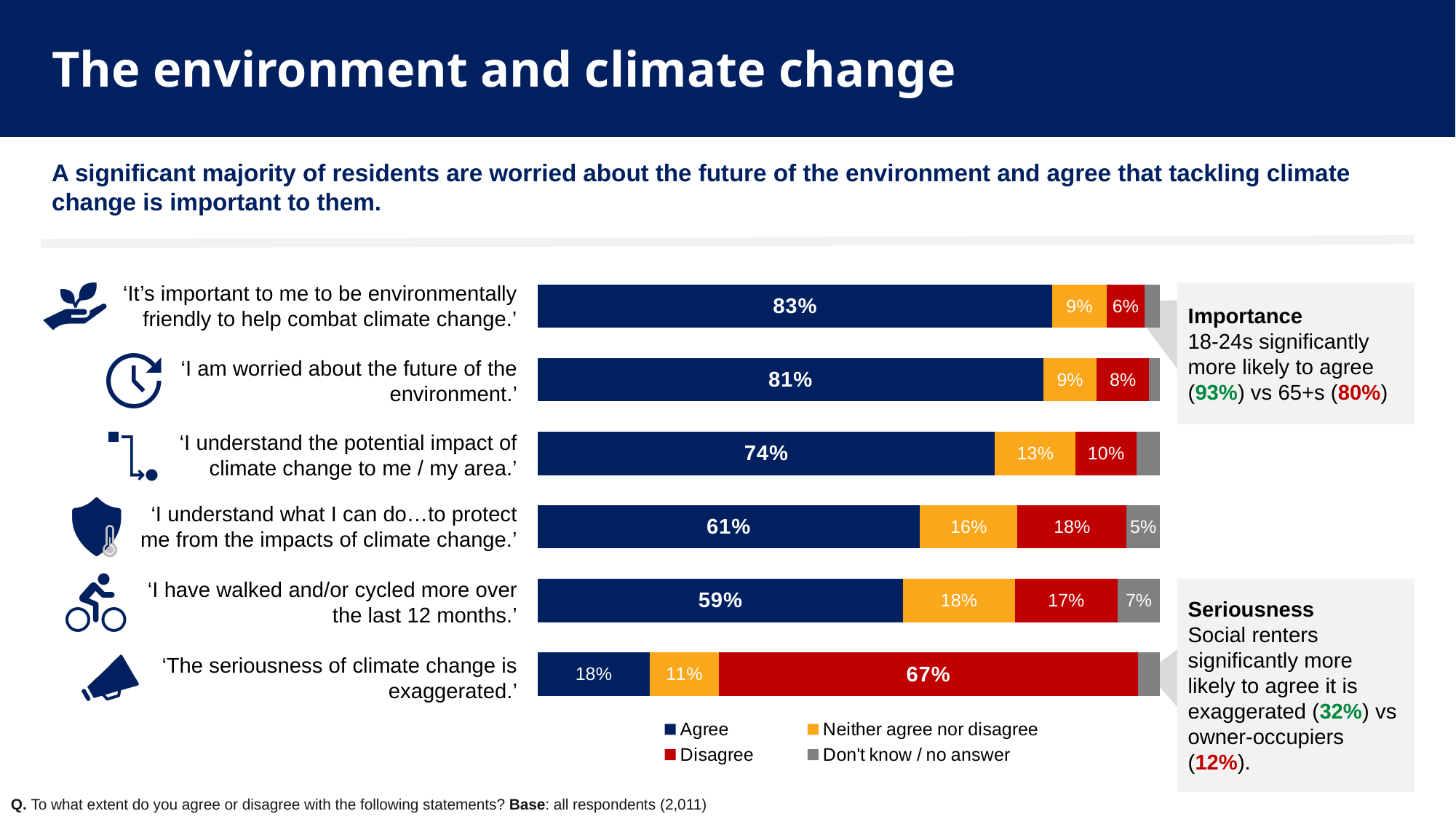
What is the 'Neither agree nor disagree' value for 'I understand the potential impact of climate change to me / my area'? 13% What type of chart is used on this slide? Stacked bar chart Which statement has the highest 'Agree' percentage? 'It's important to me to be environmentally friendly to help combat climate change.' How many response categories does the legend list? 4 Which has a higher 'Disagree' percentage: 'I understand what I can do…to protect me from the impacts of climate change' or 'I have walked and/or cycled more over the last 12 months'? 'I understand what I can do…to protect me from the impacts of climate change.' How many statements are shown in the chart? 6 What colour represents 'Disagree' in the chart? Red What percentage of respondents agree with the statement 'I am worried about the future of the environment'? 81% What percentage of respondents disagree with the statement 'The seriousness of climate change is exaggerated'? 67% What is the difference in 'Agree' percentage between 'It's important to me to be environmentally friendly to help combat climate change' and 'I am worried about the future of the environment'? 2 percentage points Which statement has the lowest 'Agree' percentage? 'The seriousness of climate change is exaggerated.' What is the 'Don't know / no answer' value for 'I have walked and/or cycled more over the last 12 months'? 7%